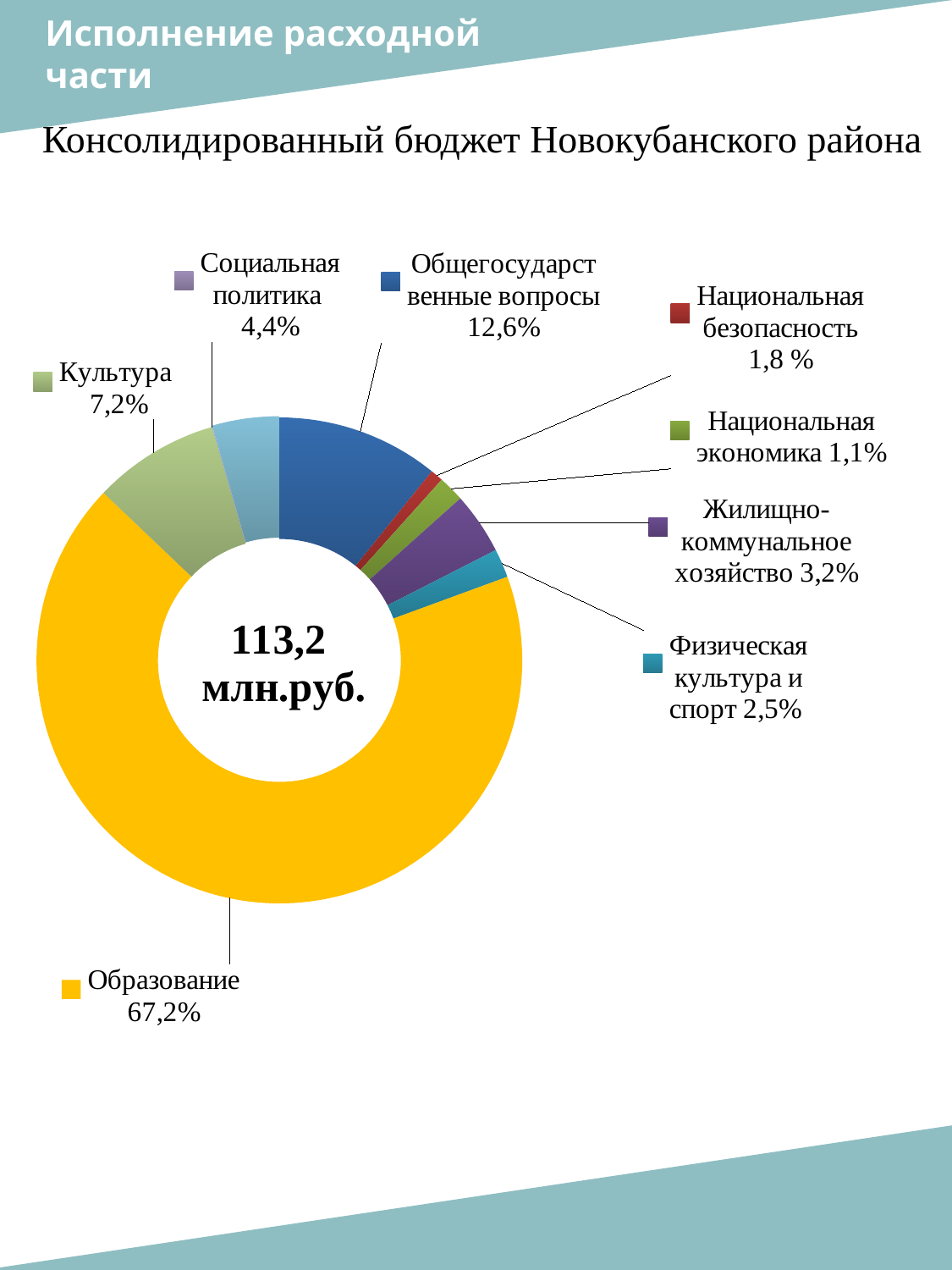
Which category has the smallest share of the chart? Национальная экономика What share is shown for Жилищно-коммунальное хозяйство? 3,2% What kind of chart is shown on the slide? Doughnut (pie) chart What is the difference in percentage points between Культура and Социальная политика? 2,8 Which category has the largest share of the chart? Образование What total amount is printed in the centre of the chart? 113,2 млн.руб. What is the difference in percentage points between Образование and Общегосударственные вопросы? 54,6 What share is shown for Общегосударственные вопросы? 12,6% Which is larger: the share for Социальная политика or the share for Физическая культура и спорт? Социальная политика What percentage is shown for Культура? 7,2% What share of the consolidated budget goes to Образование? 67,2% How many categories are shown in the chart? 8